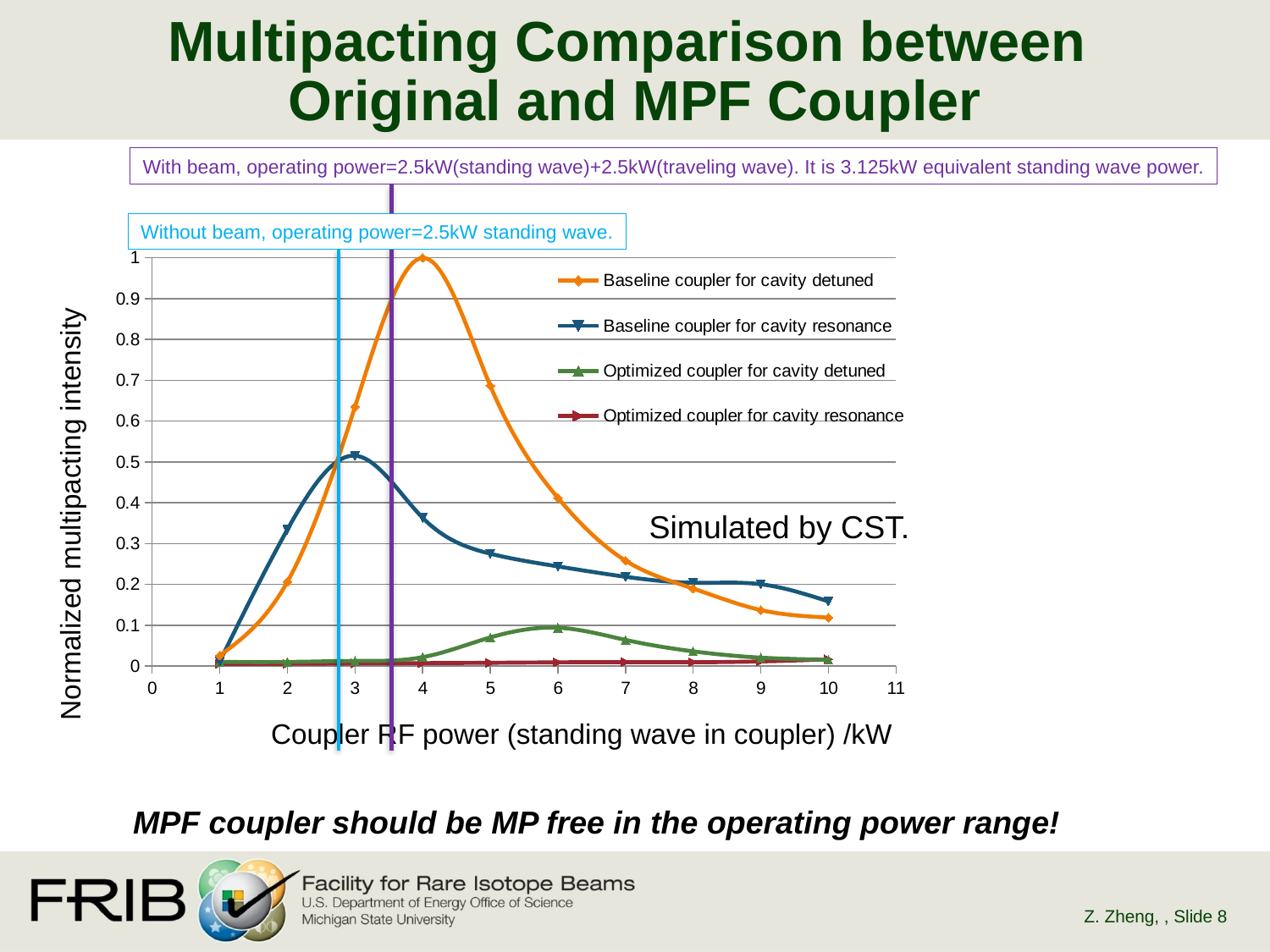
What is the title of the x axis? Coupler RF power (standing wave in coupler) /kW What is the title of the y axis? Normalized multipacting intensity Is the value for Optimized coupler for cavity detuned at 6 kW greater or less than 0.2? less At what coupler RF power does the Baseline coupler for cavity detuned curve reach its peak? 4 How many series does the legend list? 4 What is the peak normalized multipacting intensity of the Baseline coupler for cavity detuned series? 1 Is the value for Baseline coupler for cavity detuned at 5 kW greater or less than 0.5? greater Which series reaches the highest normalized multipacting intensity? Baseline coupler for cavity detuned At 4 kW, which is larger: Baseline coupler for cavity detuned or Baseline coupler for cavity resonance? Baseline coupler for cavity detuned Is the value for Baseline coupler for cavity resonance at 3 kW greater or less than 0.4? greater What kind of chart is shown on the slide? line chart